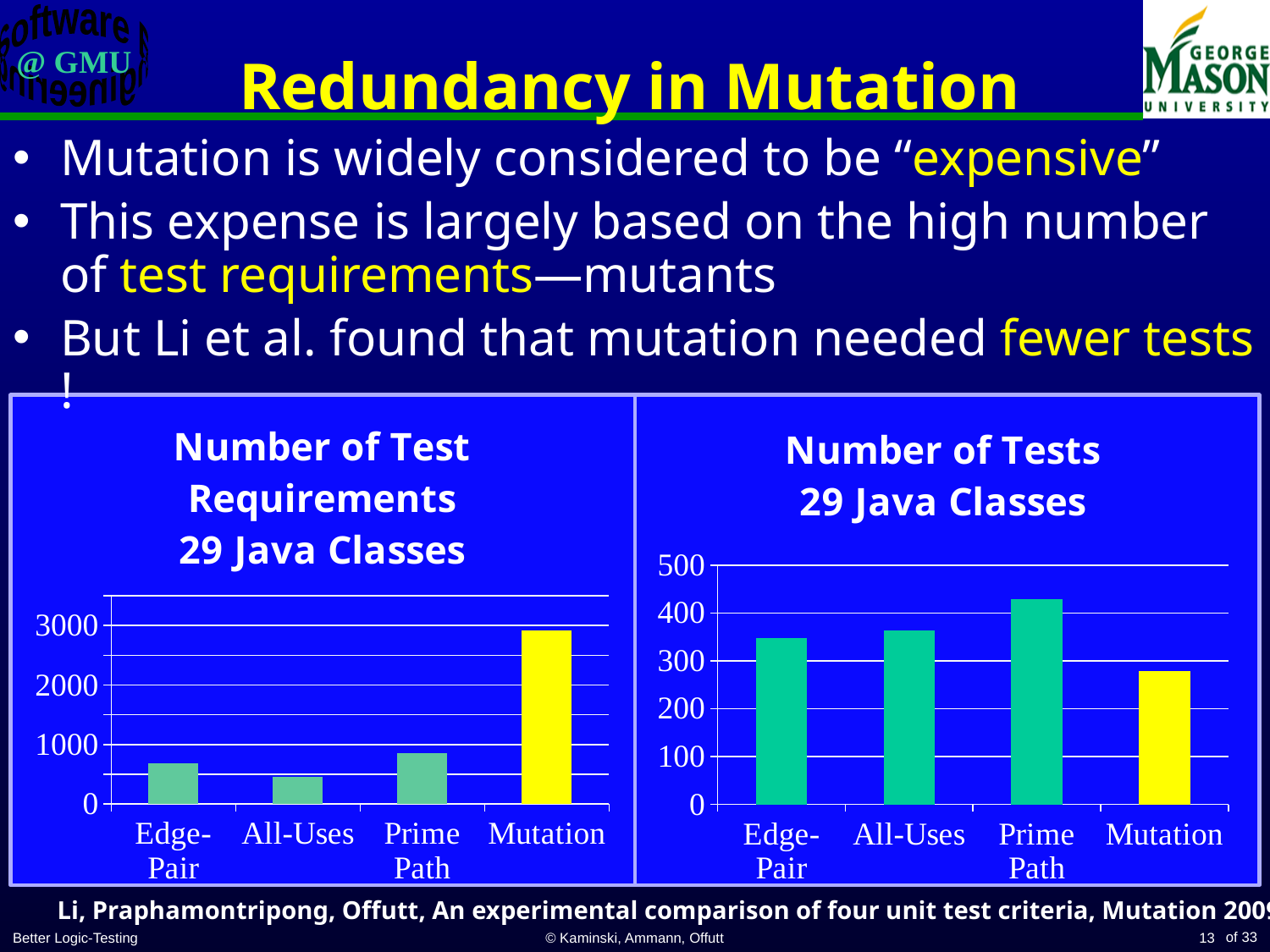
In the chart titled "Number of Test Requirements 29 Java Classes", which category has the lowest value? All-Uses In the right chart (Number of Tests), is the value for Prime Path greater or less than 400? greater In the chart titled "Number of Tests 29 Java Classes", which category has the highest value? Prime Path In the right chart (Number of Tests), is the value for Mutation greater or less than 300? less In the left chart (Number of Test Requirements), is the value for Mutation greater or less than 2000? greater In the chart titled "Number of Tests 29 Java Classes", which category has the lowest value? Mutation How many categories are shown in the chart titled "Number of Tests 29 Java Classes"? 4 What kind of chart is the left chart titled "Number of Test Requirements 29 Java Classes"? Bar chart In the right chart (Number of Tests), which is larger, the value for Prime Path or the value for Mutation? Prime Path In the chart titled "Number of Test Requirements 29 Java Classes", which category has the highest value? Mutation In the left chart (Number of Test Requirements), which is larger, the value for Edge-Pair or the value for All-Uses? Edge-Pair